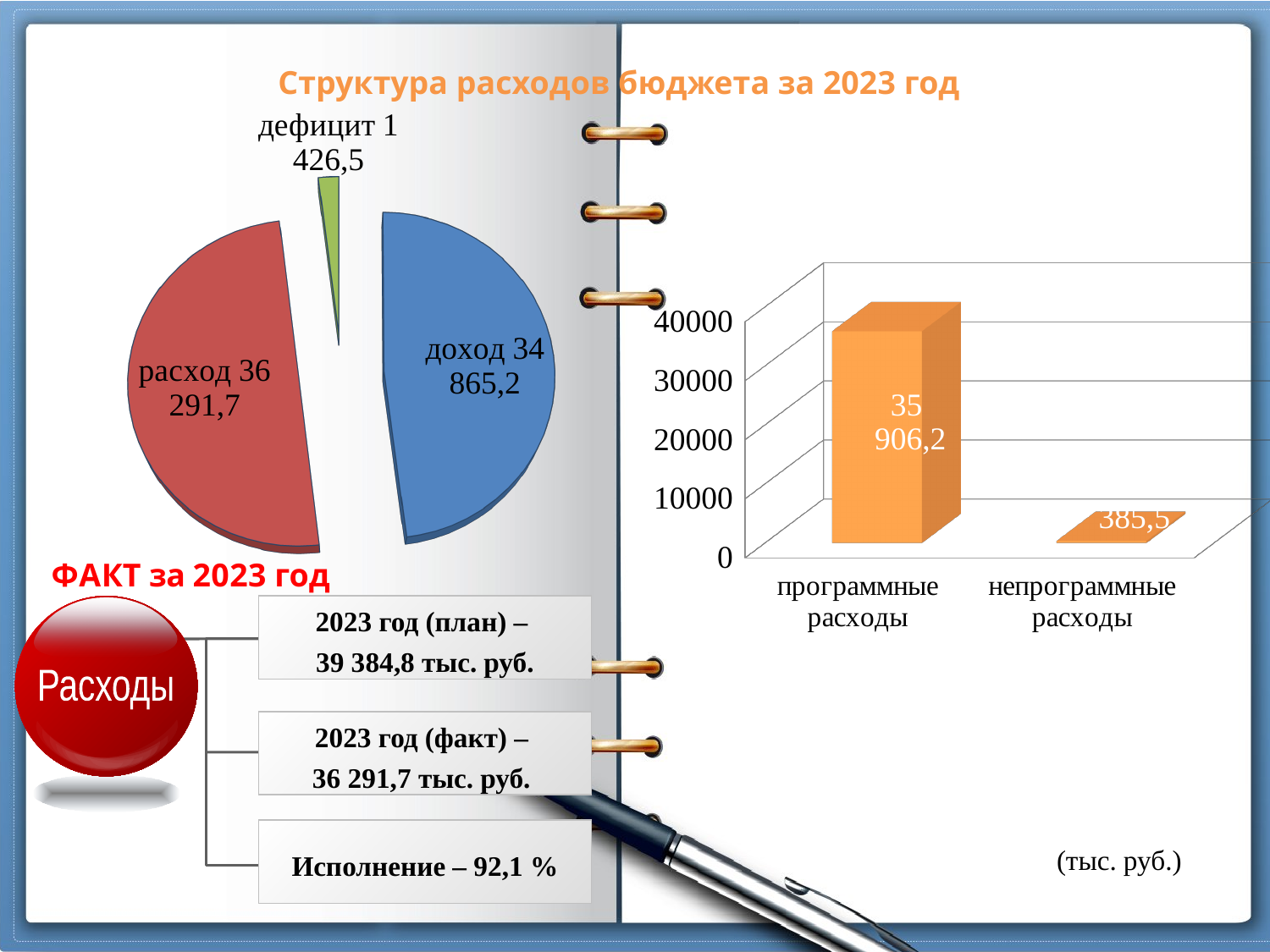
In the pie chart on the left, which category has the smallest value? дефицит In the bar chart on the right, is the value for программные расходы greater or less than 30000? greater What kind of chart is shown on the right side of the slide? bar chart In the pie chart on the left, what is the value for расход? 36 291,7 In the bar chart on the right, what is the value for непрограммные расходы? 385,5 In the bar chart on the right, what is the value for программные расходы? 35 906,2 In the pie chart on the left, which category has the largest value? расход In the pie chart on the left, what is the difference between расход and доход? 1 426,5 In the pie chart on the left, what is the value for доход? 34 865,2 In the pie chart on the left, how many slices are there? 3 In the pie chart on the left, what is the value for дефицит? 1 426,5 In the bar chart on the right, what is the difference between программные расходы and непрограммные расходы? 35 520,7